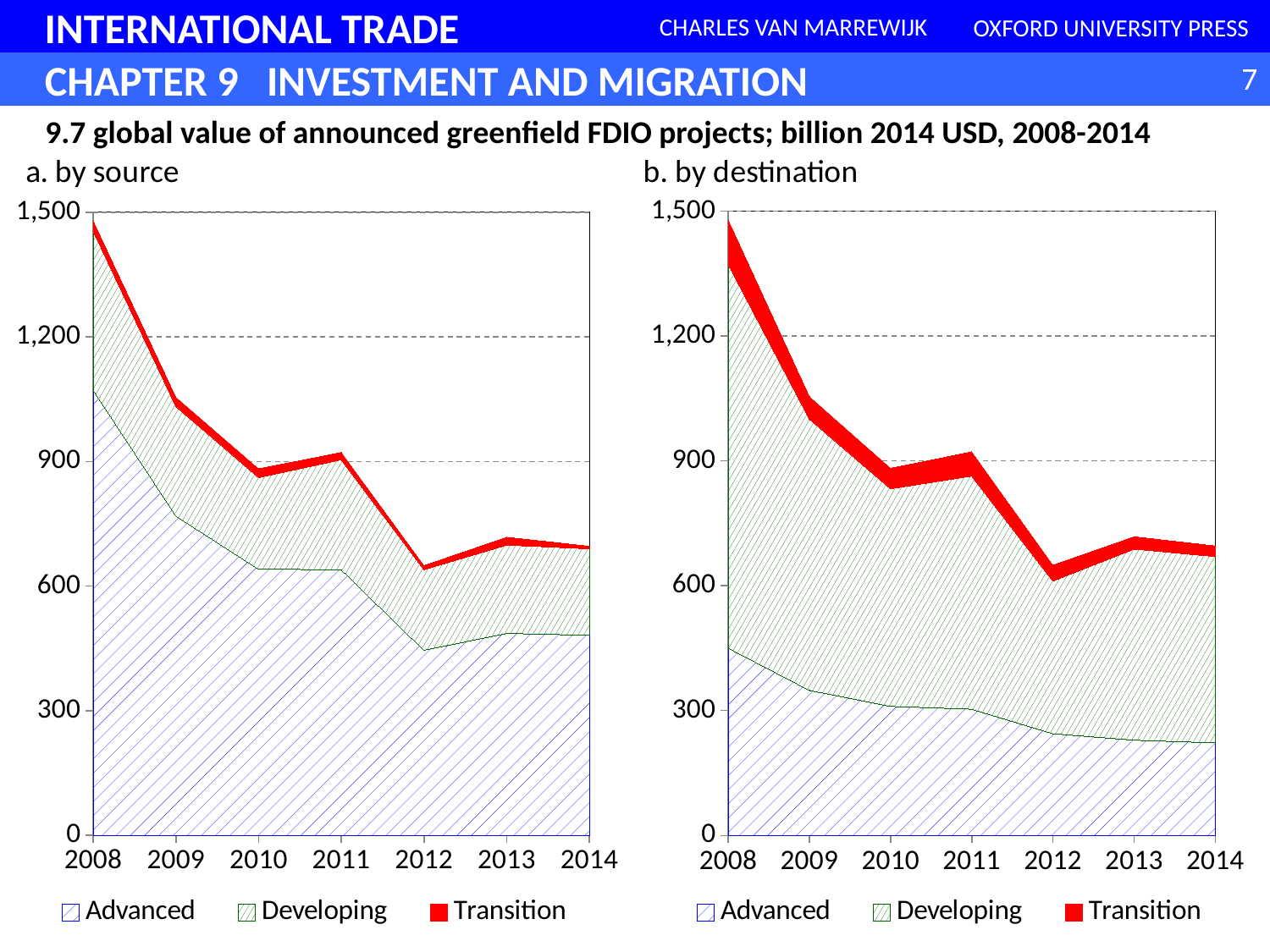
How many series does the legend of "b. by destination" list? 3 In "b. by destination", is the value for Advanced in 2008 greater or less than 300? greater Is the Advanced value in 2008 larger in "a. by source" or in "b. by destination"? a. by source In "a. by source", is the value for Advanced in 2008 greater or less than 900? greater Which series is shown in solid red in both charts? Transition In "a. by source", does the Advanced series rise or fall from 2008 to 2014? fall How many years are shown on the x axis of "a. by source"? 7 What kind of chart is "a. by source"? stacked area chart In "a. by source", which year has the highest total stacked value? 2008 In "b. by destination", is the total stacked value in 2014 greater or less than 900? less